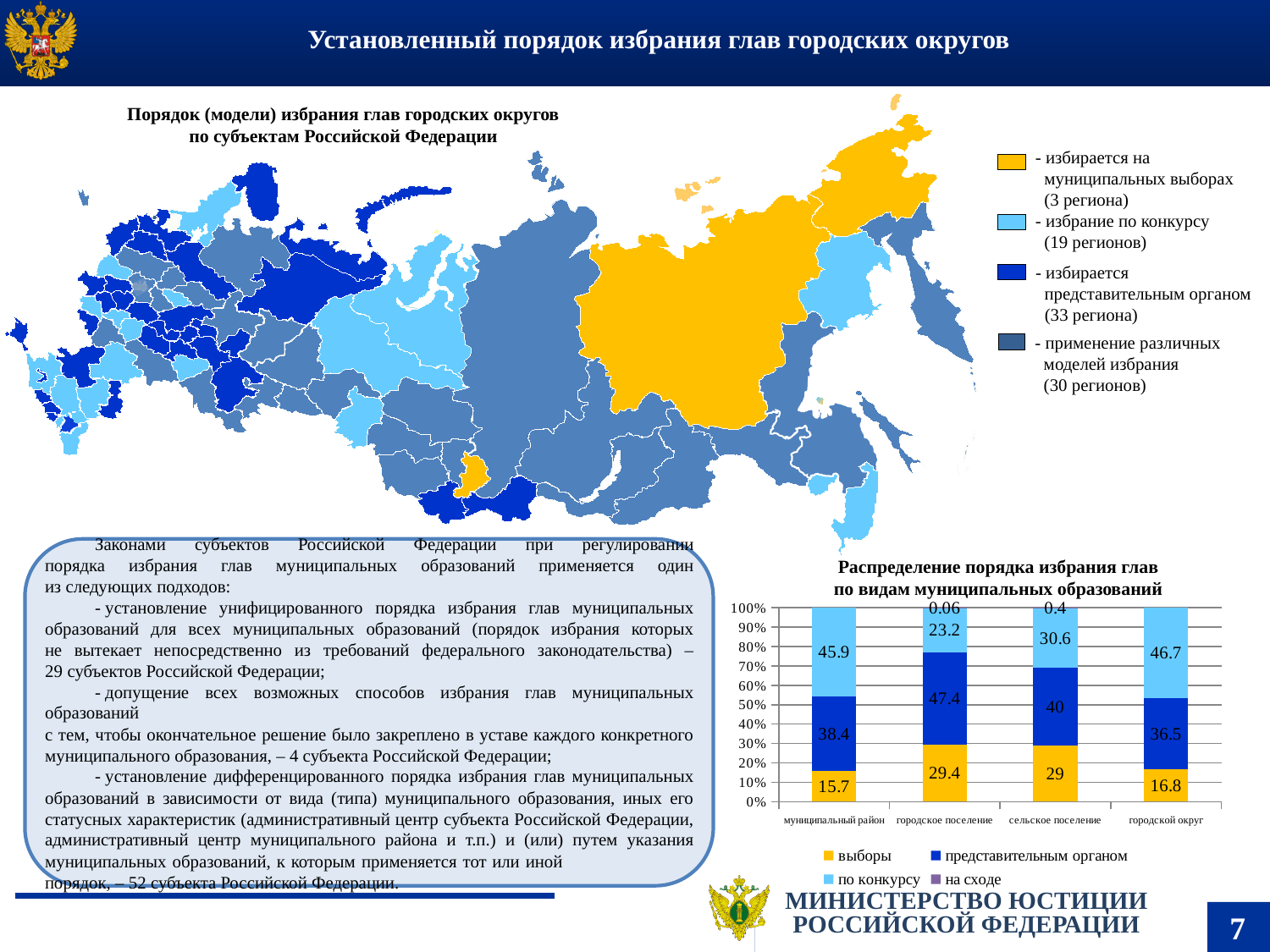
What kind of chart is 'Распределение порядка избрания глав по видам муниципальных образований'? stacked bar chart In the chart 'Распределение порядка избрания глав по видам муниципальных образований', what is the difference between the 'по конкурсу' values for 'городской округ' and 'городское поселение'? 23.5 In the chart 'Распределение порядка избрания глав по видам муниципальных образований', which colour represents the 'выборы' series? yellow How many series does the legend of the chart 'Распределение порядка избрания глав по видам муниципальных образований' list? 4 How many categories are shown on the x axis of the chart 'Распределение порядка избрания глав по видам муниципальных образований'? 4 In the chart 'Распределение порядка избрания глав по видам муниципальных образований', what is the value for 'на сходе' in the 'сельское поселение' bar? 0.4 In the chart 'Распределение порядка избрания глав по видам муниципальных образований', which is larger: the 'выборы' value for 'городское поселение' or for 'сельское поселение'? городское поселение In the chart 'Распределение порядка избрания глав по видам муниципальных образований', which category has the highest value for 'представительным органом'? городское поселение In the chart 'Распределение порядка избрания глав по видам муниципальных образований', what is the value for 'выборы' in the 'муниципальный район' bar? 15.7 In the chart 'Распределение порядка избрания глав по видам муниципальных образований', what is the value for 'представительным органом' in the 'городское поселение' bar? 47.4 In the chart 'Распределение порядка избрания глав по видам муниципальных образований', what is the value for 'по конкурсу' in the 'городской округ' bar? 46.7 In the chart 'Распределение порядка избрания глав по видам муниципальных образований', which category has the lowest value for 'выборы'? муниципальный район